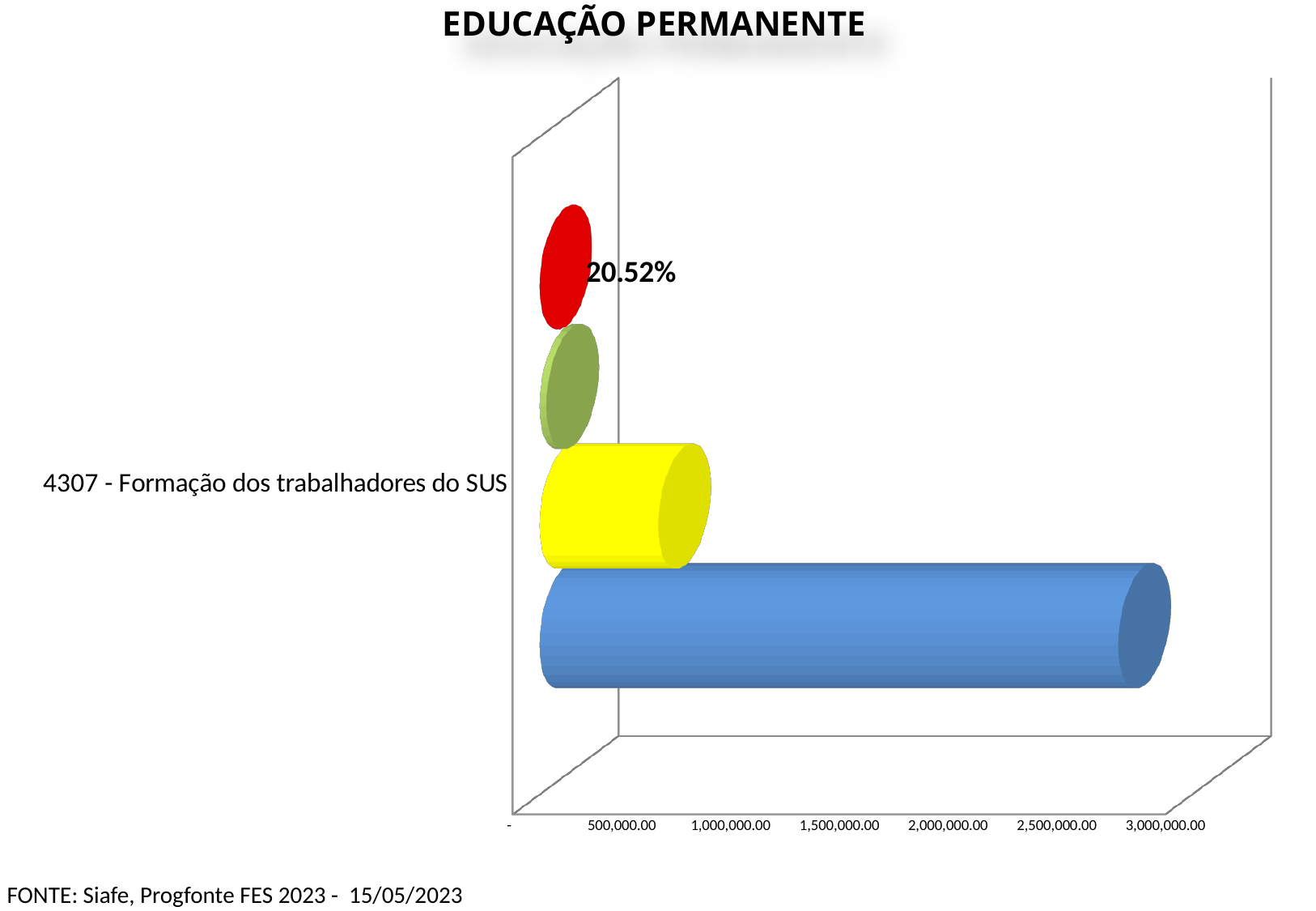
What kind of chart is shown on the slide? bar chart What percentage value is printed as a data label on the red bar? 20.52% Is the value of the blue bar greater or less than 2,500,000.00? greater What is the name of the category shown on the chart? 4307 - Formação dos trabalhadores do SUS How many bars are plotted for the category 4307 - Formação dos trabalhadores do SUS? 4 Is the value of the green bar greater or less than 500,000.00? less Is the value of the yellow bar greater or less than 1,000,000.00? less What is the highest value shown on the horizontal axis? 3,000,000.00 How many categories are shown on the vertical axis of the chart? 1 Which is larger, the blue bar or the yellow bar? blue bar What is the title of the chart? EDUCAÇÃO PERMANENTE Which coloured bar is the longest in the chart? blue